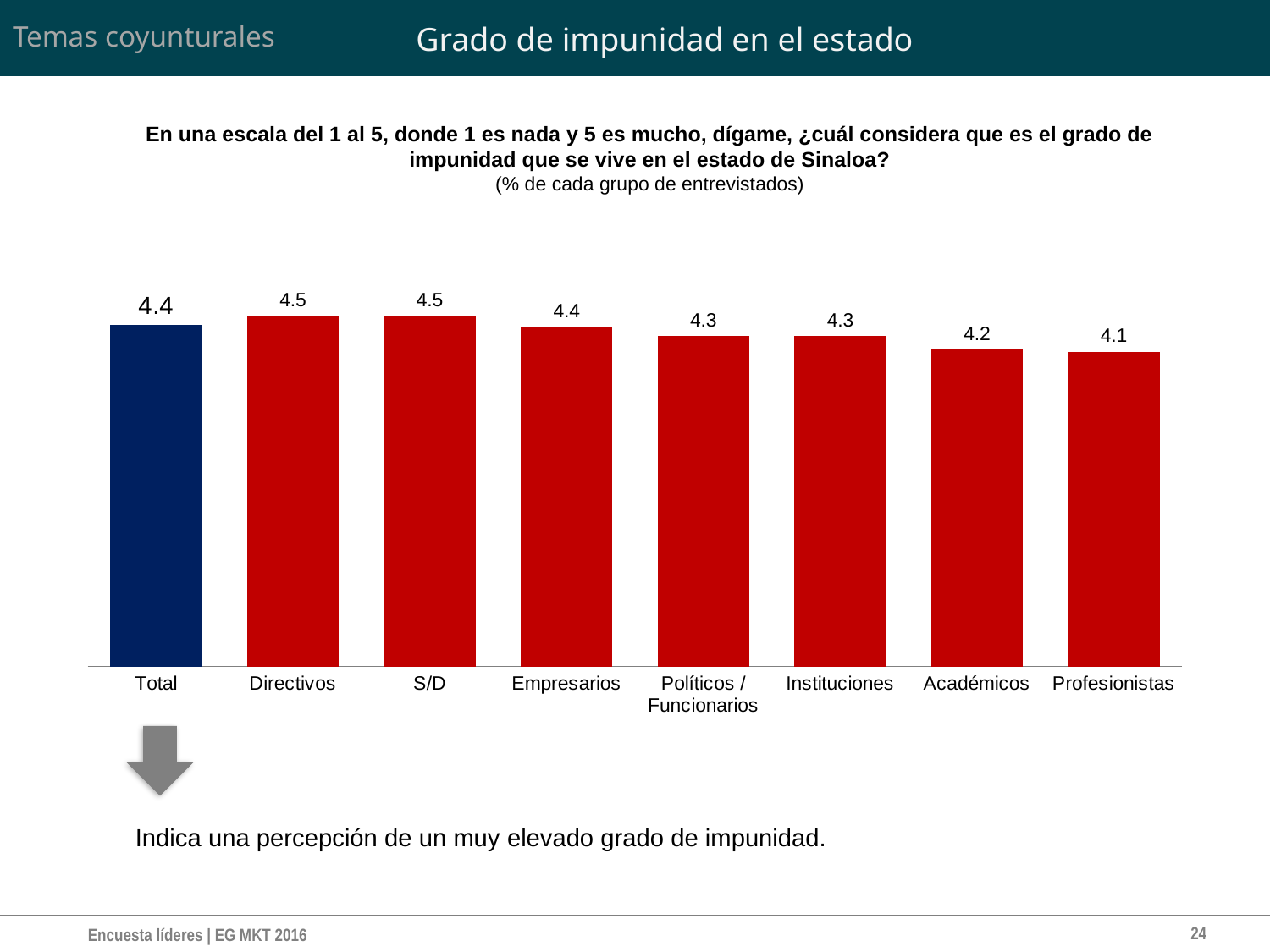
From Directivos to Profesionistas, do the values rise or fall along the x axis? Fall What is the value for Directivos? 4.5 Which category has the lowest value? Profesionistas Which is larger, the value for Empresarios or the value for Académicos? Empresarios Which bar is coloured differently from the others? Total What is the value for Políticos / Funcionarios? 4.3 What is the value for Académicos? 4.2 What kind of chart is shown on the slide? Bar chart What is the value for Profesionistas? 4.1 How many categories are shown on the x axis? 8 What is the difference between the values for Directivos and Profesionistas? 0.4 What is the value for Total? 4.4